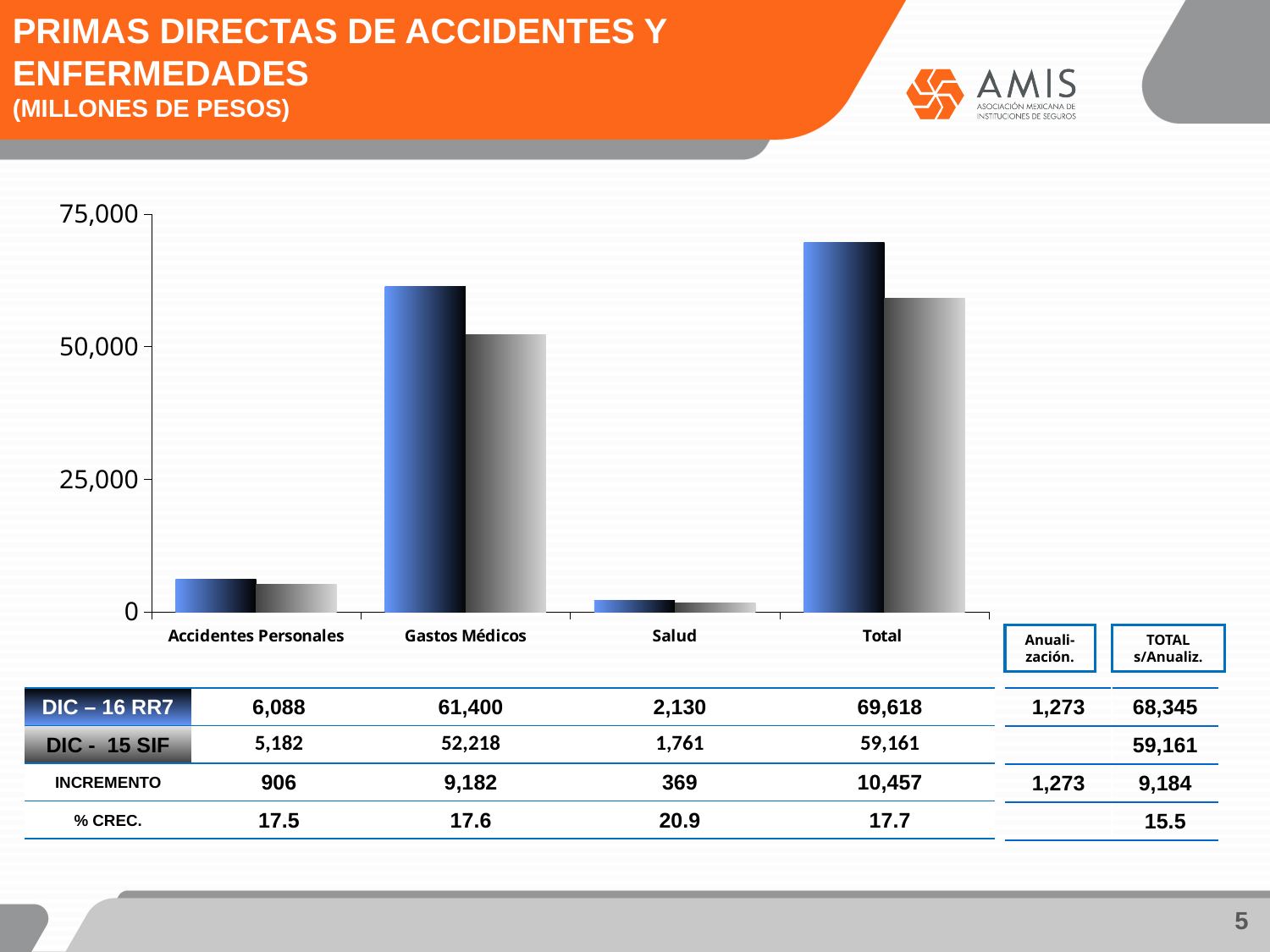
Which is larger for Accidentes Personales: the DIC – 16 RR7 value or the DIC - 15 SIF value? DIC – 16 RR7 What is the title of the chart on the slide? PRIMAS DIRECTAS DE ACCIDENTES Y ENFERMEDADES (MILLONES DE PESOS) Is the DIC – 16 RR7 value for Total greater or less than 50,000? greater What is the DIC – 16 RR7 value for Gastos Médicos? 61,400 Excluding Total, which category has the highest DIC – 16 RR7 value? Gastos Médicos What is the difference between the DIC – 16 RR7 and DIC - 15 SIF values for Gastos Médicos? 9,182 What is the DIC – 16 RR7 value for Salud? 2,130 What is the DIC - 15 SIF value for Accidentes Personales? 5,182 What kind of chart is shown on the slide? bar chart What is the DIC - 15 SIF value for Total? 59,161 Which category has the lowest DIC - 15 SIF value? Salud How many categories are shown on the x axis of the chart? 4